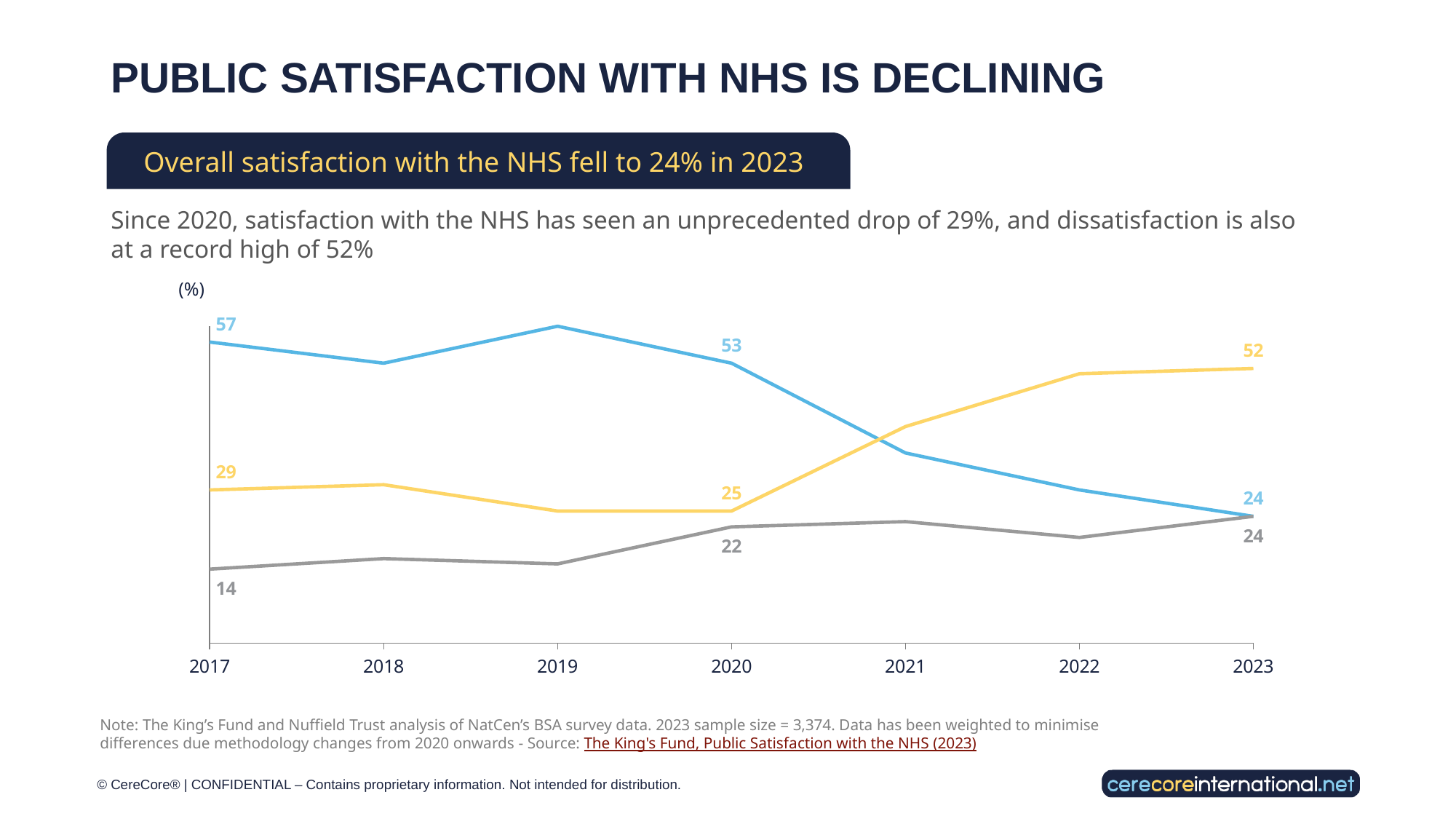
How many years are shown on the x axis? 7 Which line has the highest value in 2023? Yellow line What type of chart is shown on the slide? Line chart Does the blue line rise or fall between 2020 and 2023? Fall What is the difference between the yellow line's 2023 value and its 2017 value? 23 What is the value of the grey line in 2020? 22 In 2017, which line has the higher value, the yellow line or the grey line? Yellow line What is the value of the yellow line in 2023? 52 What is the value of the yellow line in 2020? 25 What is the value of the blue line in 2017? 57 What is the value of the blue line in 2023? 24 By how much did the blue line fall between 2020 and 2023? 29